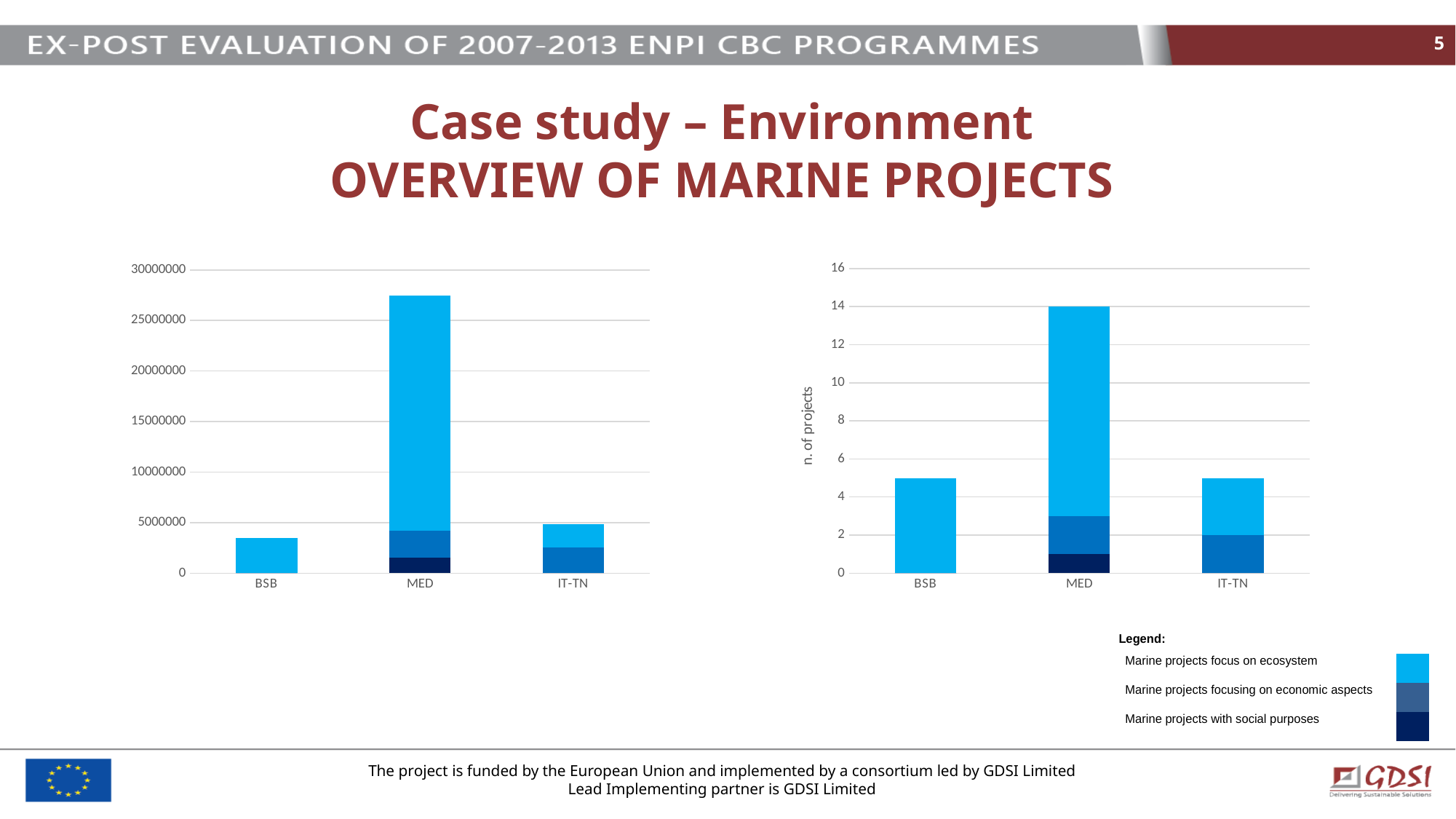
In the right-hand chart (n. of projects), which programme has the highest total number of projects? MED In the right-hand chart (n. of projects), what is the total height of the stacked bar for MED? 14 In the left-hand chart, is the total for MED greater or less than 25000000? greater In the right-hand chart (n. of projects), is the total for BSB greater or less than 4? greater How many series does the legend list for the charts? 3 In the left-hand chart, is the total for BSB greater or less than 5000000? less In the left-hand chart, which programme has the lowest total value? BSB How many programme categories are shown on the x axis of the left-hand chart? 3 What kind of chart is the right-hand chart (n. of projects)? bar chart What is the y-axis label of the right-hand chart? n. of projects In the left-hand chart, which programme has the highest total value? MED